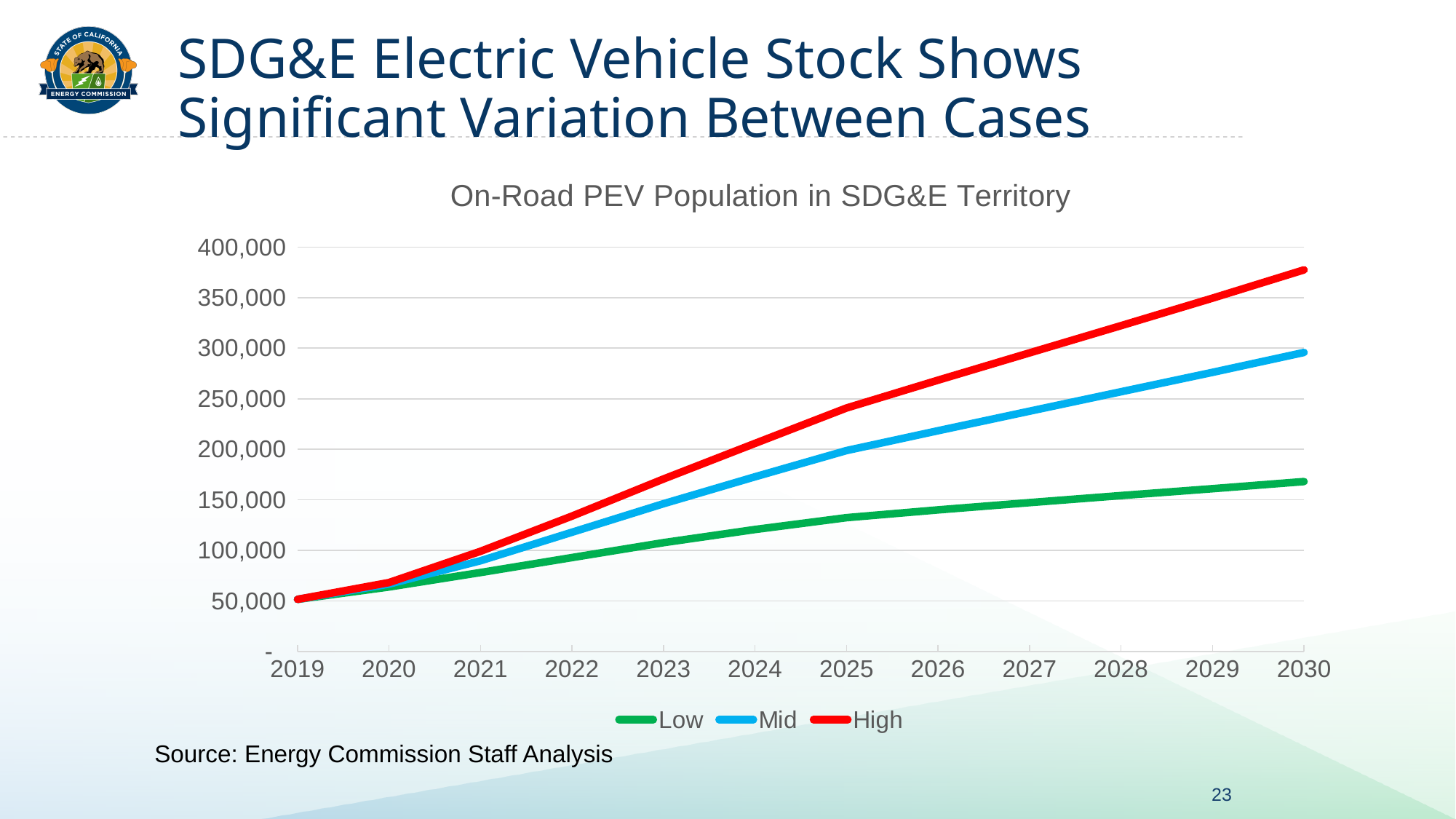
Is the value for the High series in 2030 greater or less than 350,000? greater Which series has the highest value in 2030? High Which series has the lowest value in 2030? Low What kind of chart is shown on the slide? line chart How many series does the legend list? 3 How many years are shown along the x axis? 12 What is the title of the chart? On-Road PEV Population in SDG&E Territory In 2027, which series has the larger value, Mid or Low? Mid Is the value for the Mid series in 2030 greater or less than 250,000? greater Do the values for the High series rise or fall from 2019 to 2030? rise Is the value for the Low series in 2030 greater or less than 200,000? less